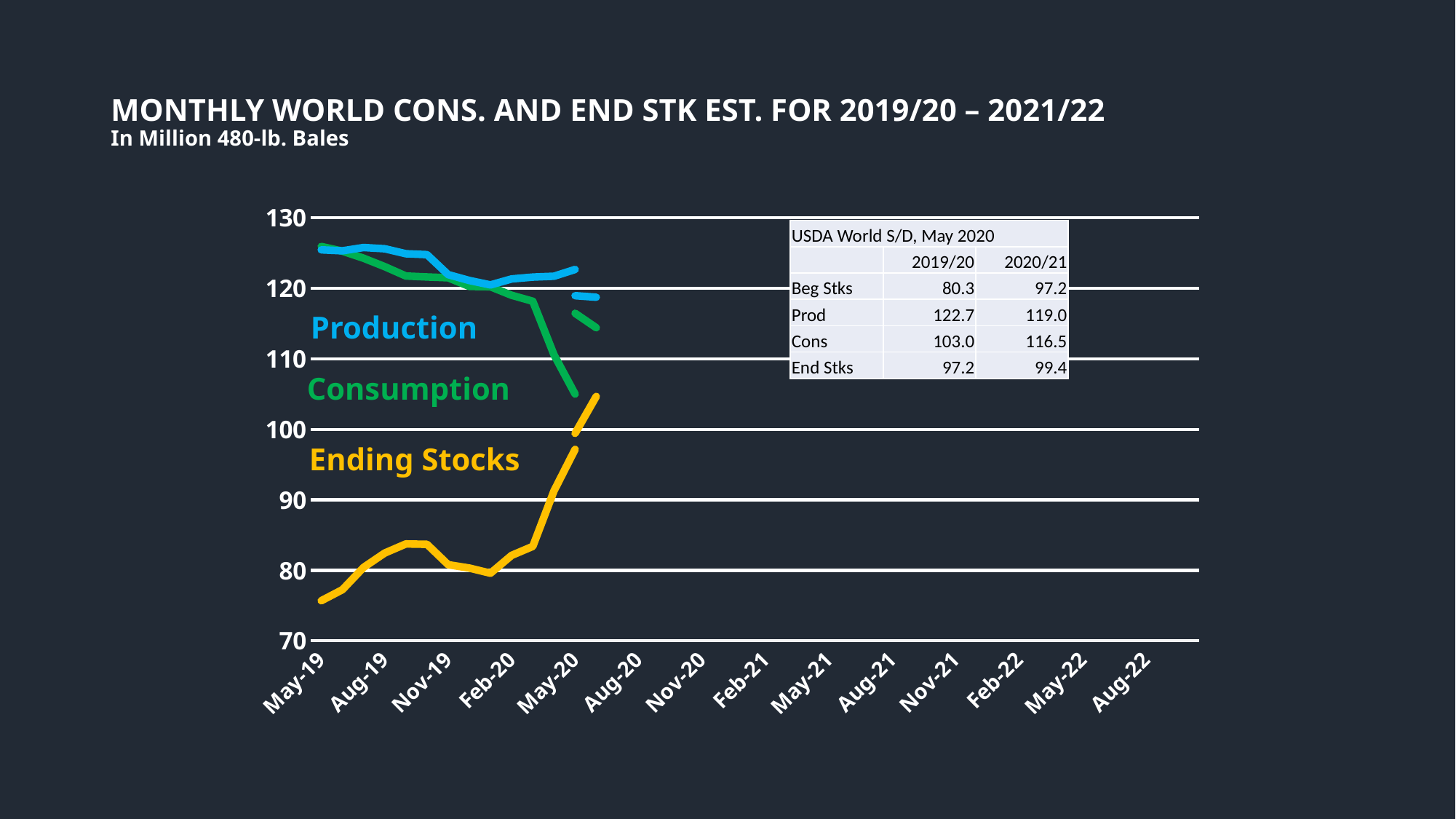
Does the Ending Stocks line rise or fall from May-19 to May-20? rise What kind of chart is shown on the slide? line chart At which month is the Ending Stocks line at its lowest? May-19 Is the Ending Stocks value at May-20 greater or less than 100? less How many month labels are shown on the x axis? 14 At May-20, which is higher, Production or Consumption? Production Is the Production value at May-19 greater or less than 120? greater Does the Consumption line rise or fall from May-19 to May-20? fall According to the USDA table on the slide, what is the 2019/20 Prod value? 122.7 How many data series are plotted on the chart? 3 Is the Ending Stocks value at May-19 greater or less than 80? less What colour is the Ending Stocks line? yellow